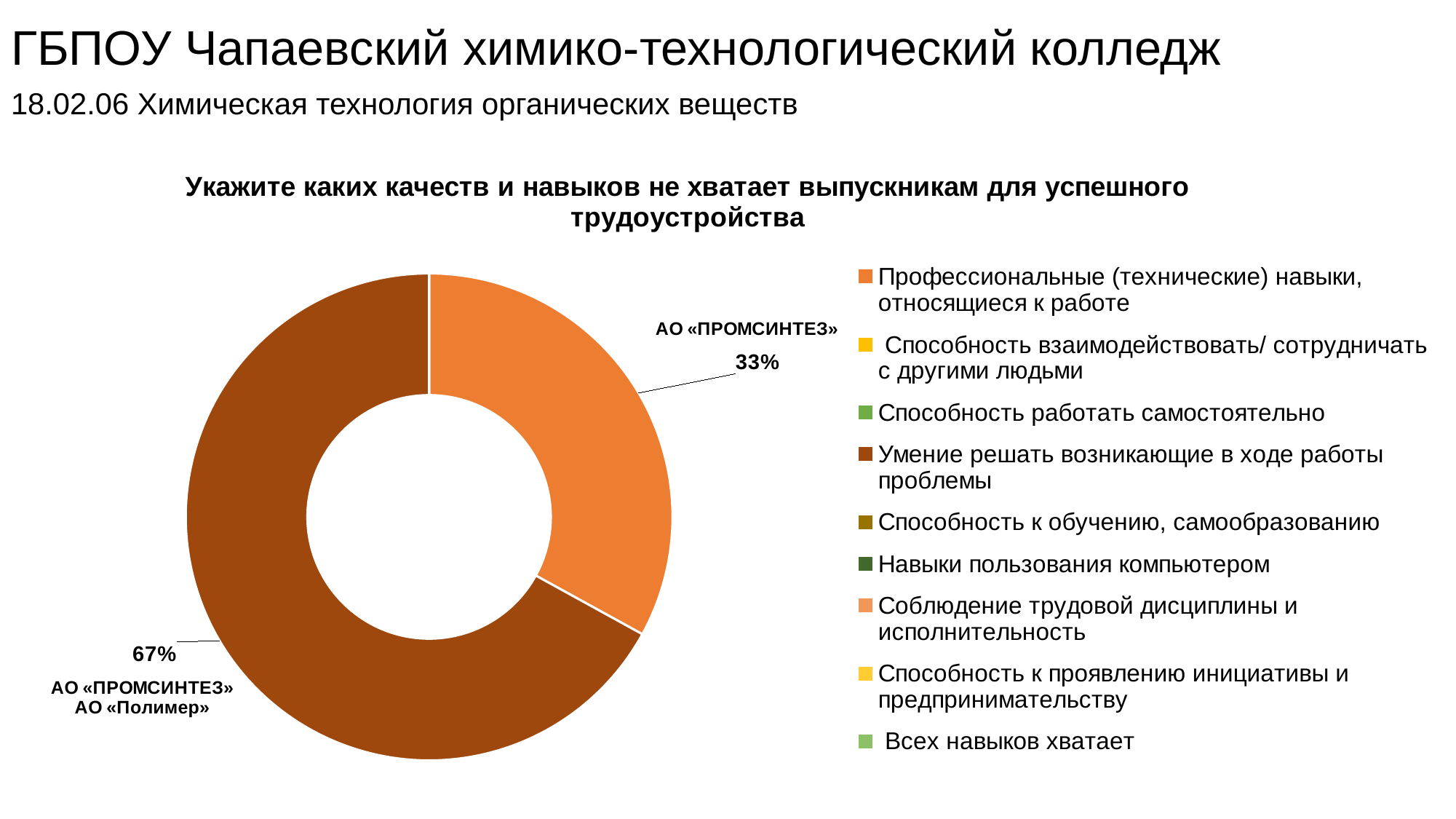
What kind of chart is shown on the slide? doughnut (pie) chart What share of the chart does the slice for «Умение решать возникающие в ходе работы проблемы» take? 67% Which employers are named in the data label next to the 67% slice? АО «ПРОМСИНТЕЗ» and АО «Полимер» How many entries does the chart legend list? 9 What share of the chart does the slice for «Профессиональные (технические) навыки, относящиеся к работе» take? 33% Which category has the largest slice in the chart? Умение решать возникающие в ходе работы проблемы What is the title of the chart? Укажите каких качеств и навыков не хватает выпускникам для успешного трудоустройства How many slices with non-zero values are visible in the chart? 2 Which of the two plotted categories has the smaller slice? Профессиональные (технические) навыки, относящиеся к работе What is the difference in percentage points between the 67% slice and the 33% slice? 34 percentage points Which slice is larger: the one labelled 33% or the one labelled 67%? the one labelled 67% Which employer is named in the data label next to the 33% slice? АО «ПРОМСИНТЕЗ»